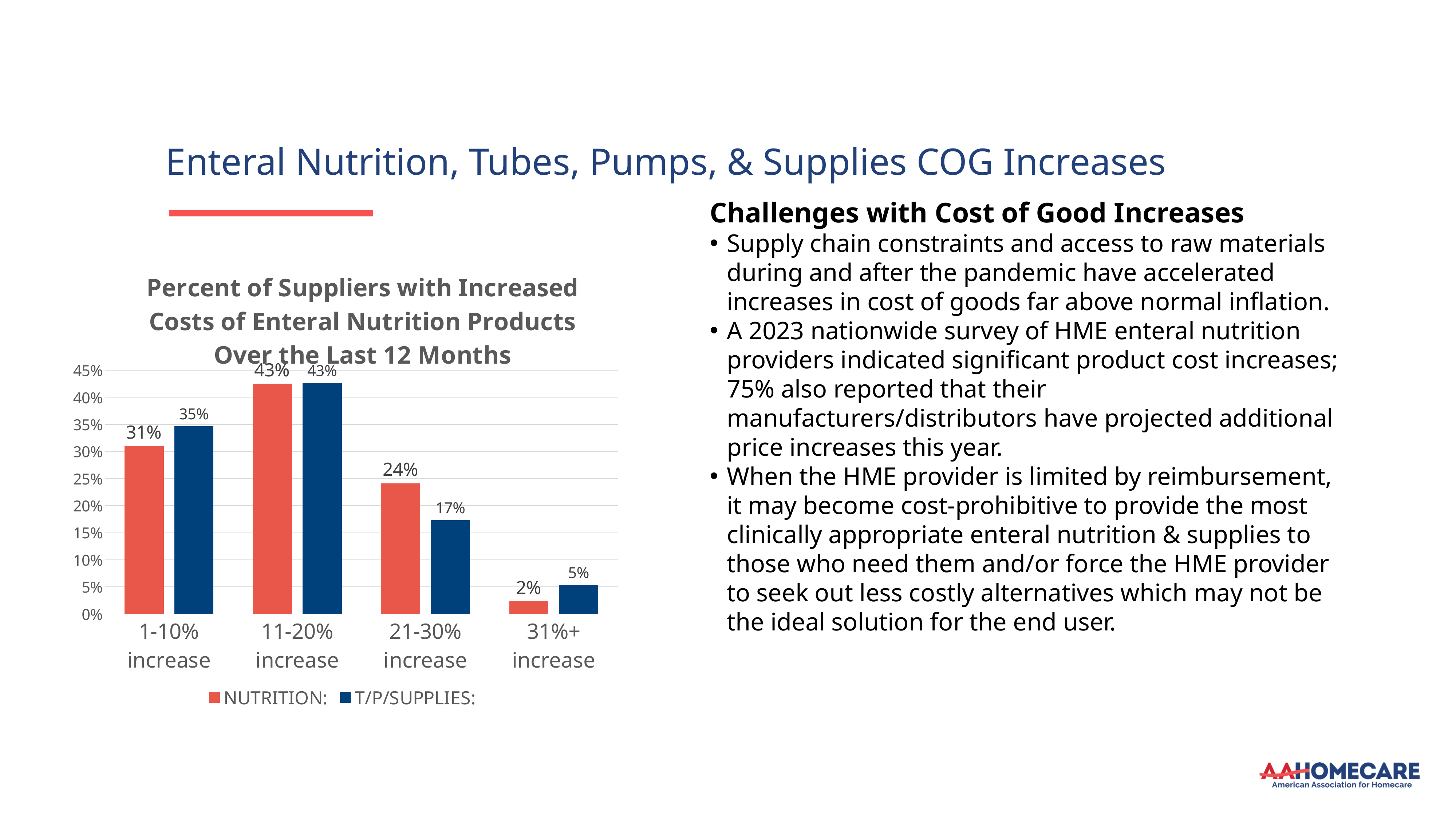
How many categories are shown on the x axis? 4 What percent of suppliers reported a 21-30% increase for T/P/SUPPLIES? 17% What is the difference between NUTRITION and T/P/SUPPLIES in the 21-30% increase category? 7% What is the title of the chart? Percent of Suppliers with Increased Costs of Enteral Nutrition Products Over the Last 12 Months How many series does the legend list? 2 What is the value for NUTRITION in the 31%+ increase category? 2% What kind of chart is shown on the slide? Bar chart Which colour represents the NUTRITION series in the chart? Red What percent of suppliers reported a 1-10% increase for NUTRITION? 31% Which category has the highest value for NUTRITION? 11-20% increase In the 1-10% increase category, which series has the larger value, NUTRITION or T/P/SUPPLIES? T/P/SUPPLIES Which category has the lowest value for T/P/SUPPLIES? 31%+ increase